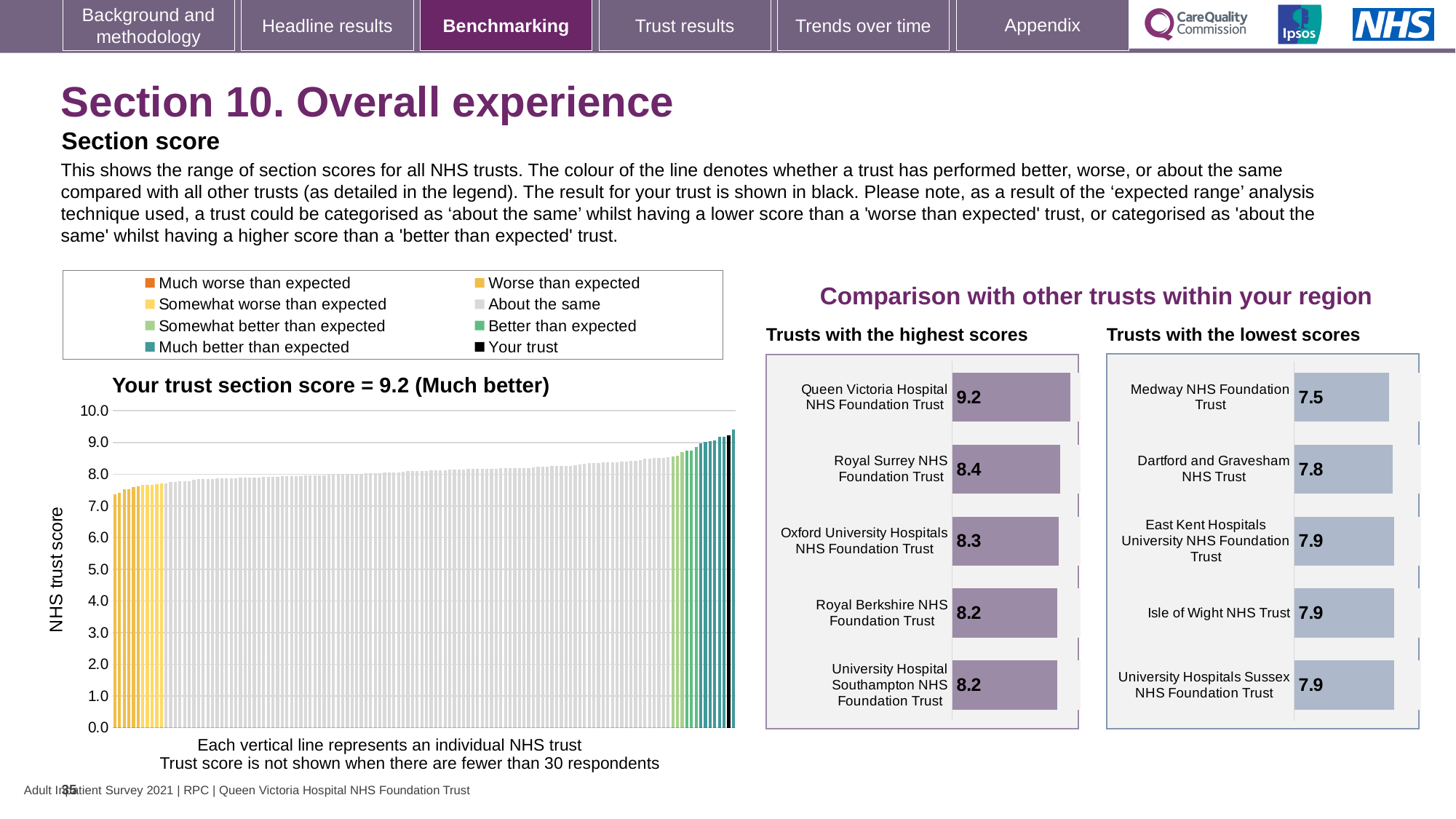
In the 'Trusts with the highest scores' chart, which trust has the highest score? Queen Victoria Hospital NHS Foundation Trust How many trusts are shown in the 'Trusts with the lowest scores' chart? 5 What type of chart is the 'Your trust section score' chart on the left? Bar chart In the 'Trusts with the highest scores' chart, what is the score for Oxford University Hospitals NHS Foundation Trust? 8.3 How many entries does the legend above the 'Your trust section score' chart list? 8 In the 'Trusts with the lowest scores' chart, which has the larger score: Medway NHS Foundation Trust or Dartford and Gravesham NHS Trust? Dartford and Gravesham NHS Trust In the 'Your trust section score' chart, do the bar values rise or fall from left to right? Rise In the 'Trusts with the highest scores' chart, what is the difference between the scores of Queen Victoria Hospital NHS Foundation Trust and Royal Surrey NHS Foundation Trust? 0.8 In the 'Trusts with the lowest scores' chart, which trust has the lowest score? Medway NHS Foundation Trust In the 'Trusts with the highest scores' chart, what is the score for Queen Victoria Hospital NHS Foundation Trust? 9.2 In the 'Trusts with the lowest scores' chart, what is the score for Medway NHS Foundation Trust? 7.5 In the 'Your trust section score' chart, is the value of the leftmost (lowest) bar greater or less than 8.0? less